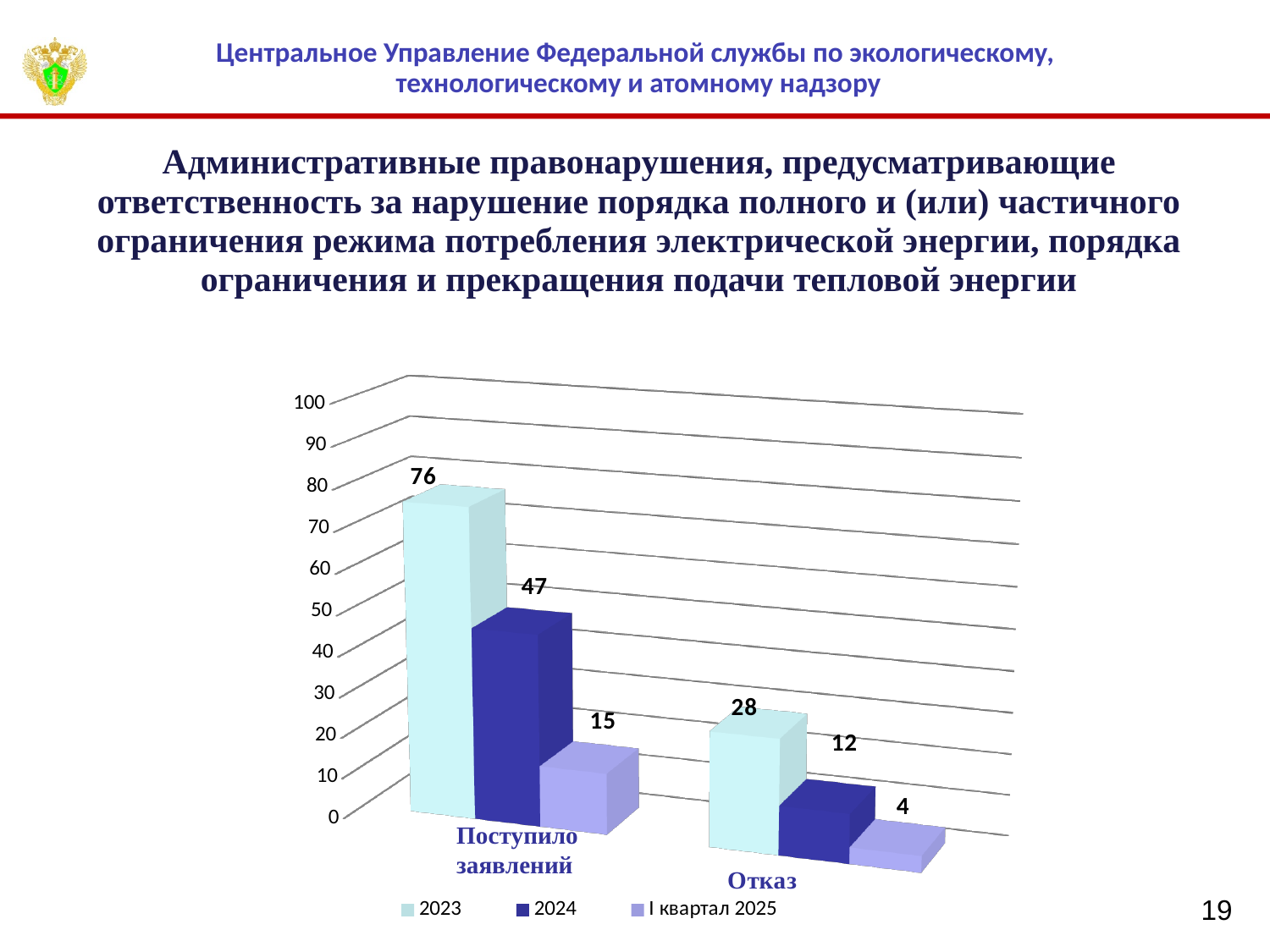
What is the difference between the 2023 and 2024 values in the "Поступило заявлений" category? 29 What is the value for "I квартал 2025" in the "Поступило заявлений" category? 15 What is the value for 2024 in the "Отказ" category? 12 How many categories are shown on the x axis? 2 How many series does the legend list? 3 Which is larger: the 2024 value for "Поступило заявлений" or the 2023 value for "Отказ"? 2024 value for "Поступило заявлений" Which series has the highest value in the "Поступило заявлений" category? 2023 Which series has the lowest value in the "Отказ" category? I квартал 2025 What is the value for 2023 in the "Отказ" category? 28 What kind of chart is shown on the slide? Bar chart What is the difference between the 2023 and 2024 values in the "Отказ" category? 16 What is the value for 2023 in the "Поступило заявлений" category? 76